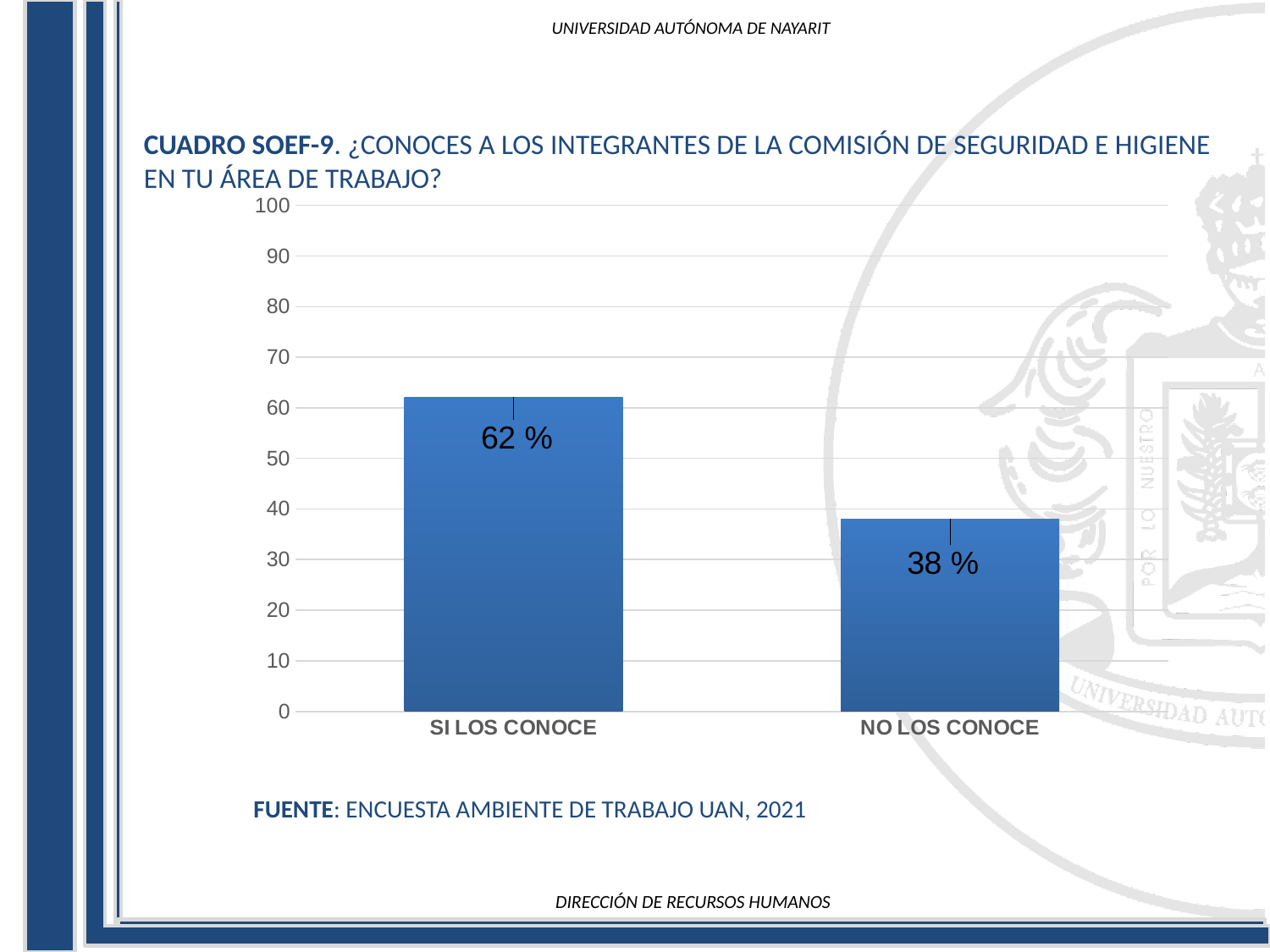
Which category has the highest value? SI LOS CONOCE What is the value for SI LOS CONOCE? 62 % Which is larger, the value for SI LOS CONOCE or the value for NO LOS CONOCE? SI LOS CONOCE How many categories are shown on the x axis? 2 Is the value for SI LOS CONOCE greater or less than 60? greater What is the highest value shown on the y axis? 100 What kind of chart is shown on the slide? bar chart What is the value for NO LOS CONOCE? 38 % Is the value for NO LOS CONOCE greater or less than 50? less What source is cited below the chart? ENCUESTA AMBIENTE DE TRABAJO UAN, 2021 What is the difference between the values for SI LOS CONOCE and NO LOS CONOCE? 24 % Which category has the lowest value? NO LOS CONOCE